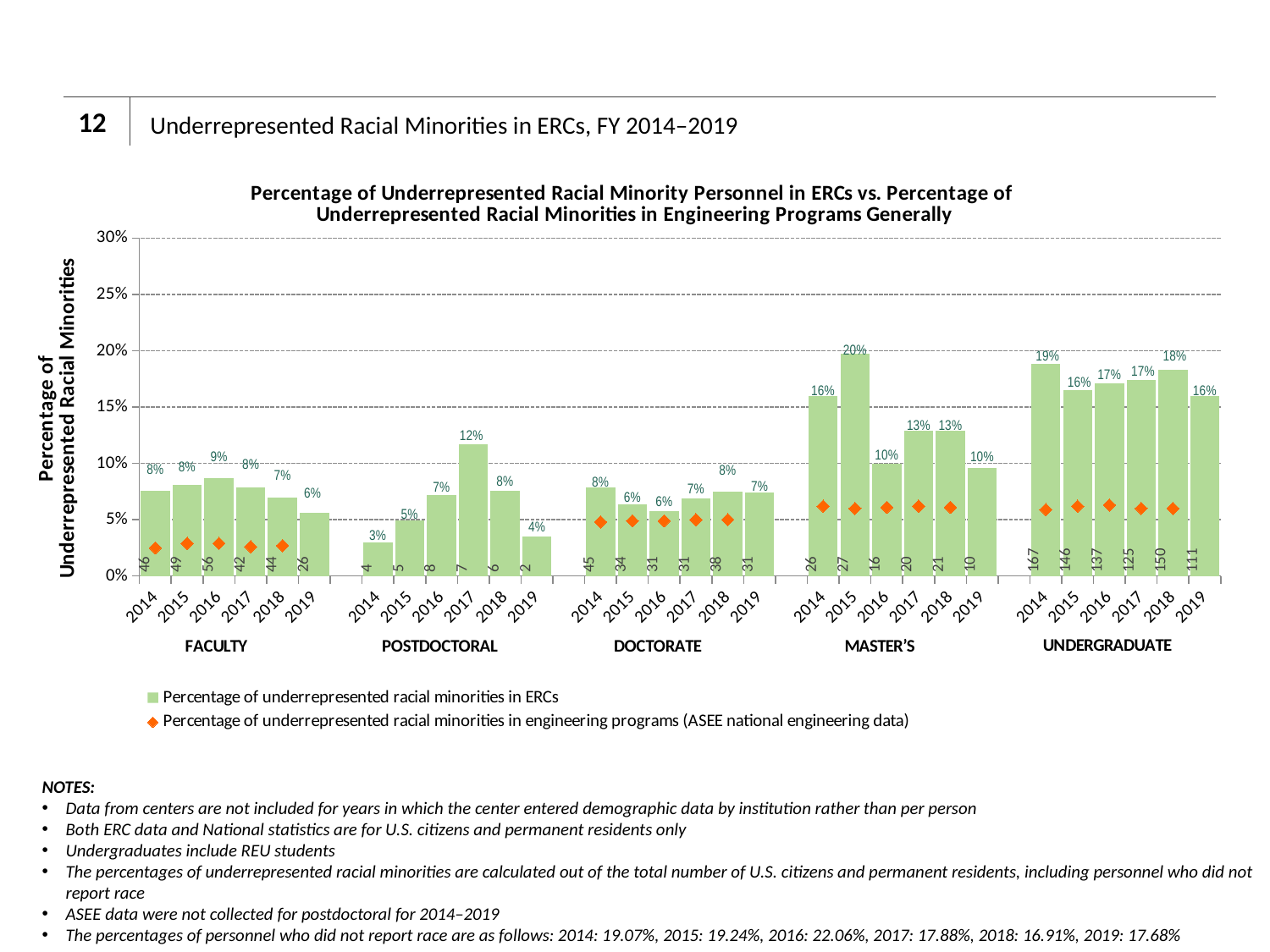
How many series does the legend list? 2 Is the Master's 2015 bar for underrepresented racial minorities in ERCs greater or less than 15%? greater What marker shape represents the percentage of underrepresented racial minorities in engineering programs (ASEE national engineering data)? Orange diamond What is the percentage of underrepresented racial minorities in ERCs for Postdoctoral in 2017? 12% What is the percentage of underrepresented racial minorities in ERCs for Undergraduate in 2014? 19% What is the percentage of underrepresented racial minorities in ERCs for Master's in 2015? 20% Which year has the highest percentage of underrepresented racial minorities in ERCs within the Master's group? 2015 How many personnel groups (categories) are shown along the x axis? 5 Which year has the lowest percentage of underrepresented racial minorities in ERCs within the Postdoctoral group? 2014 What kind of chart is used to show the percentage of underrepresented racial minorities in ERCs? Bar chart Which is larger: the Undergraduate 2014 percentage or the Undergraduate 2015 percentage of underrepresented racial minorities in ERCs? Undergraduate 2014 What is the difference between the Master's 2015 percentage (20%) and the Master's 2016 percentage (10%) of underrepresented racial minorities in ERCs? 10%